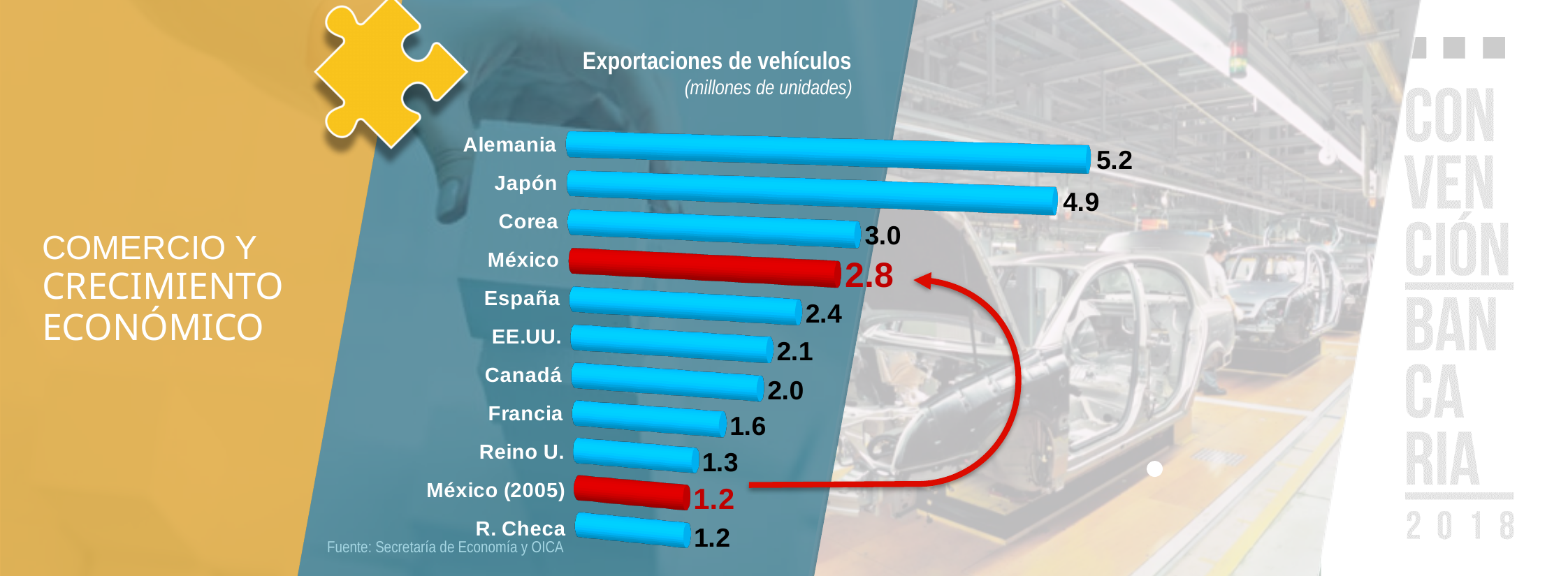
What is the difference between the values for México and México (2005)? 1.6 Which is larger, the value for España or the value for EE.UU.? España What is the value for México (2005) in the vehicle exports chart? 1.2 What is the title of the chart? Exportaciones de vehículos What is the difference between the values for Alemania and Japón? 0.3 How many categories are shown in the vehicle exports chart? 11 Which category has the highest value in the vehicle exports chart? Alemania What unit is given in the chart subtitle? millones de unidades What is the value for México in the vehicle exports chart? 2.8 Which is larger, the value for Corea or the value for México? Corea What is the value for Alemania in the vehicle exports chart? 5.2 What kind of chart is shown on the slide? Bar chart